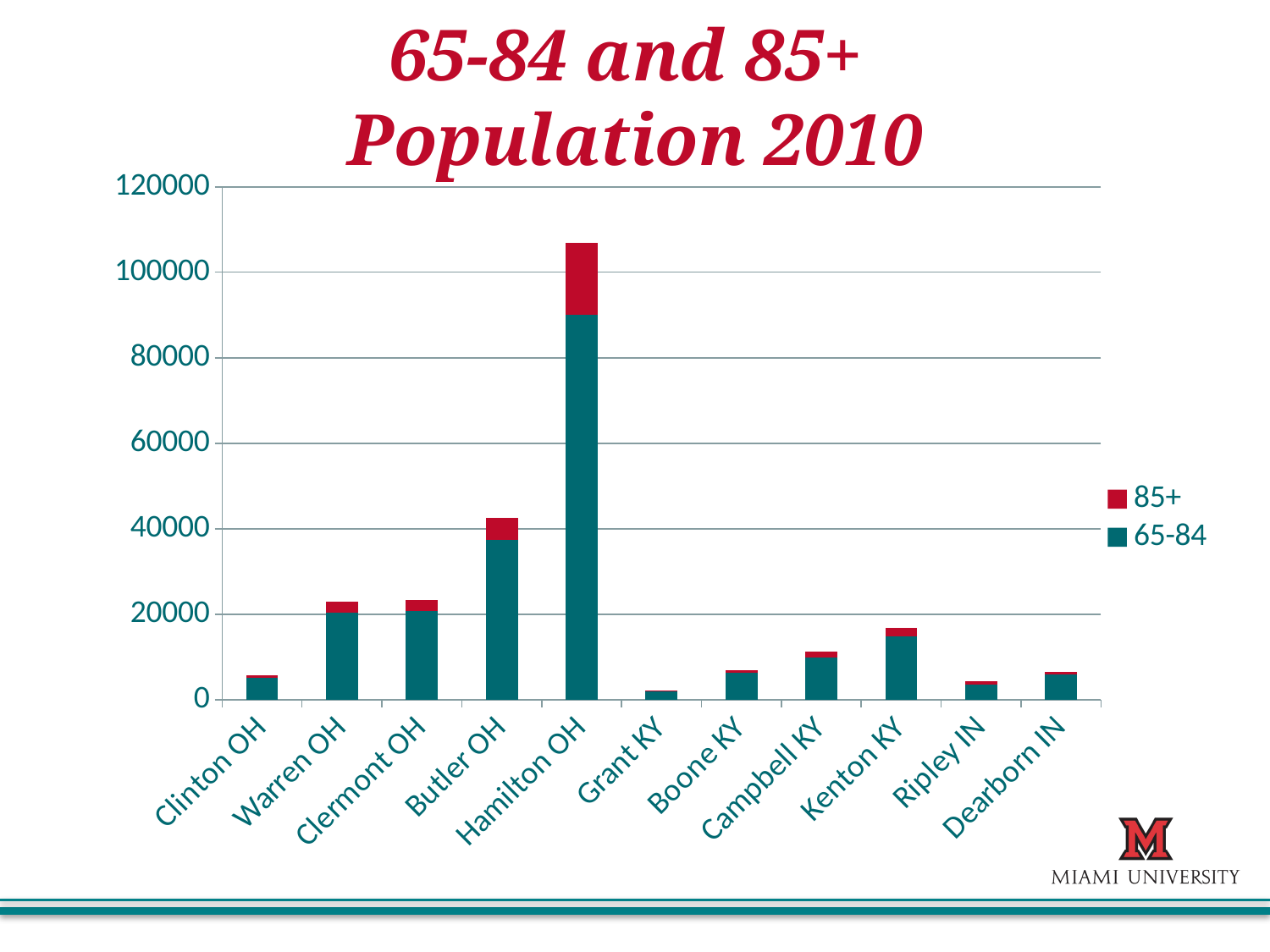
Is the total value for Butler OH greater or less than 40000? greater Which county has the lowest total 65-84 and 85+ population? Grant KY Which series is shown in red in the legend? 85+ How many series does the legend list? 2 Which county has the highest total 65-84 and 85+ population? Hamilton OH Is the total value for Hamilton OH greater or less than 100000? greater How many counties are shown on the x axis of the chart? 11 Which has the larger total bar, Butler OH or Warren OH? Butler OH What kind of chart is shown on the slide? stacked bar chart Is the total value for Kenton KY greater or less than 20000? less Which has the larger total bar, Kenton KY or Campbell KY? Kenton KY